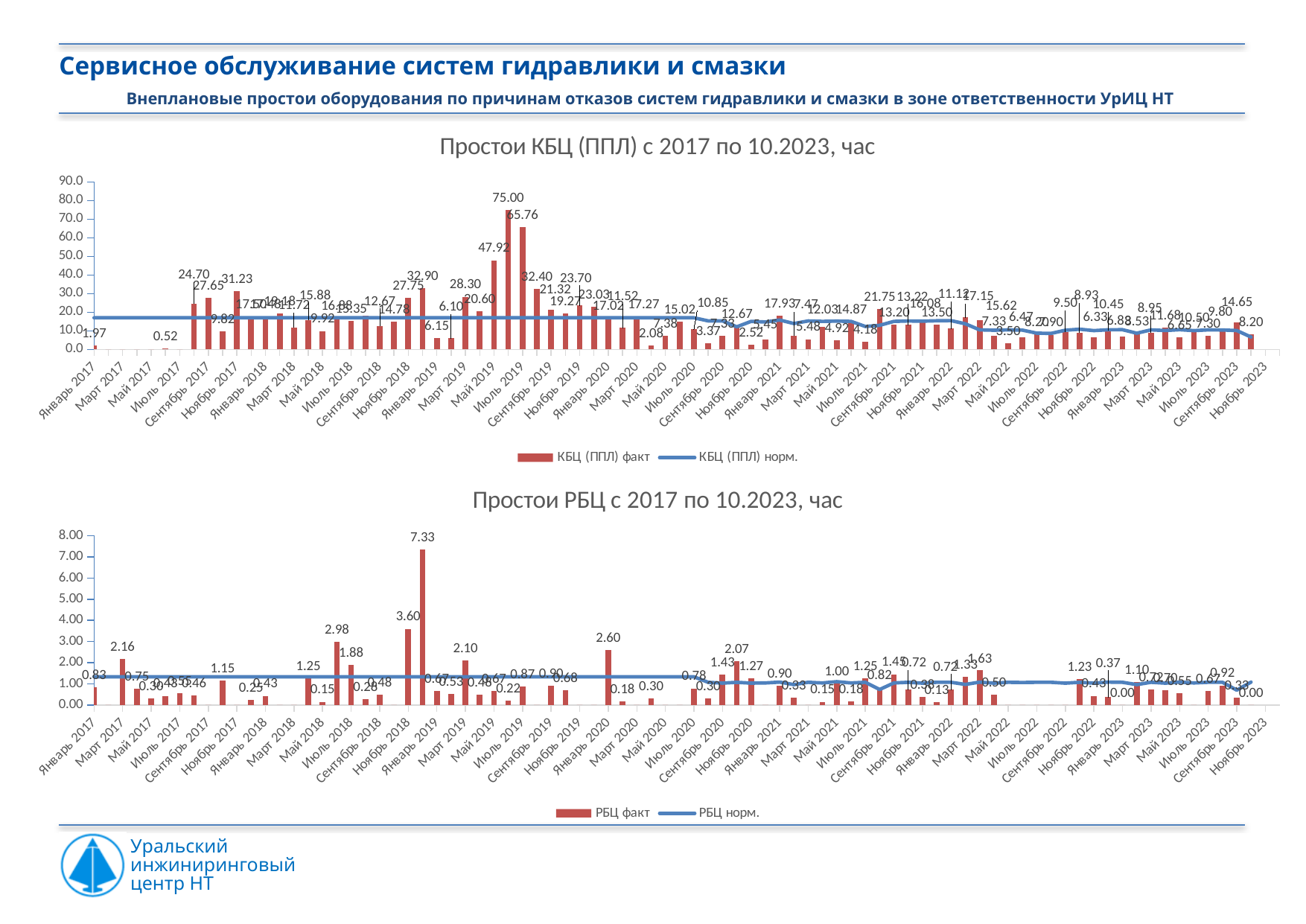
What are the legend entries of the top chart? КБЦ (ППЛ) факт; КБЦ (ППЛ) норм. In the chart 'Простои РБЦ с 2017 по 10.2023, час', which is larger: the bar labelled 2.98 or the bar labelled 2.60? 2.98 In the chart 'Простои КБЦ (ППЛ) с 2017 по 10.2023, час', is the bar for Январь 2017 greater or less than 10.0? less How many series does the legend of the top chart list? 2 How many charts are on the slide? 2 In the chart 'Простои КБЦ (ППЛ) с 2017 по 10.2023, час', what is the highest bar value? 75.00 In the chart 'Простои КБЦ (ППЛ) с 2017 по 10.2023, час', what is the difference between the two tallest bars, labelled 75.00 and 65.76? 9.24 In the chart 'Простои РБЦ с 2017 по 10.2023, час', what is the value of the bar for Январь 2017? 0.83 In the chart 'Простои РБЦ с 2017 по 10.2023, час', what is the difference between the bars labelled 7.33 and 3.60? 3.73 In the chart 'Простои РБЦ с 2017 по 10.2023, час', what is the highest bar value? 7.33 What kind of chart is the bottom chart 'Простои РБЦ с 2017 по 10.2023, час'? Bar chart with a line series In the chart 'Простои КБЦ (ППЛ) с 2017 по 10.2023, час', what is the value of the bar for Январь 2017? 1.97